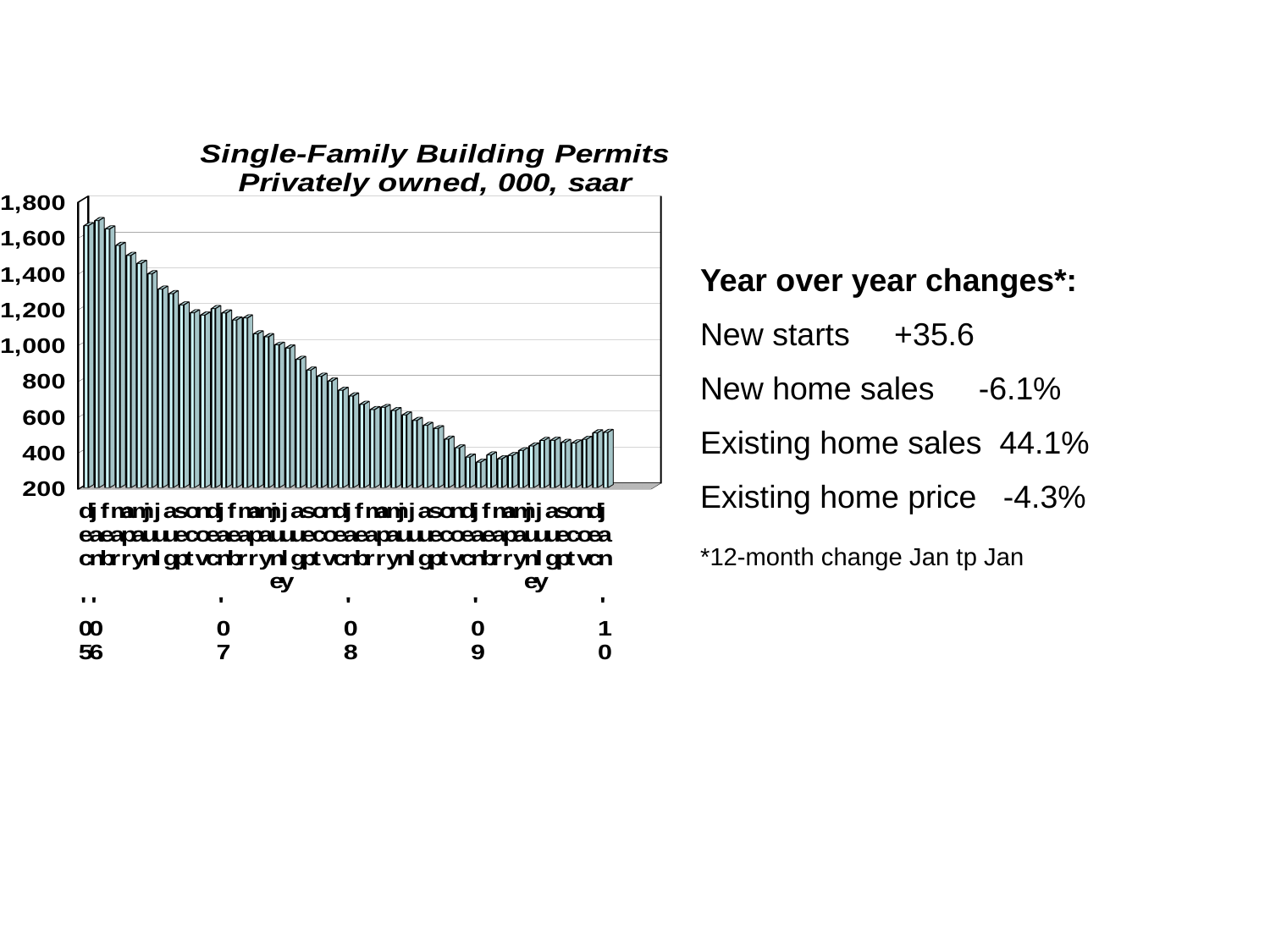
Which is larger, the first bar on the left or the last bar on the right? the first bar on the left Is the value of the last (rightmost) bar in the chart greater or less than 600? less What kind of chart is shown on the slide? bar chart Is the value of the bar at the start of 2008 (the '08' label) greater or less than 1,000? less Is the value of the first (leftmost) bar in the chart greater or less than 1,600? greater What is the highest value shown on the vertical axis of the chart? 1,800 Are the highest bars in the chart located at the left end or the right end of the x axis? left end Do the values in the chart generally rise or fall from left to right across the x axis? fall What is the title of the chart? Single-Family Building Permits Privately owned, 000, saar